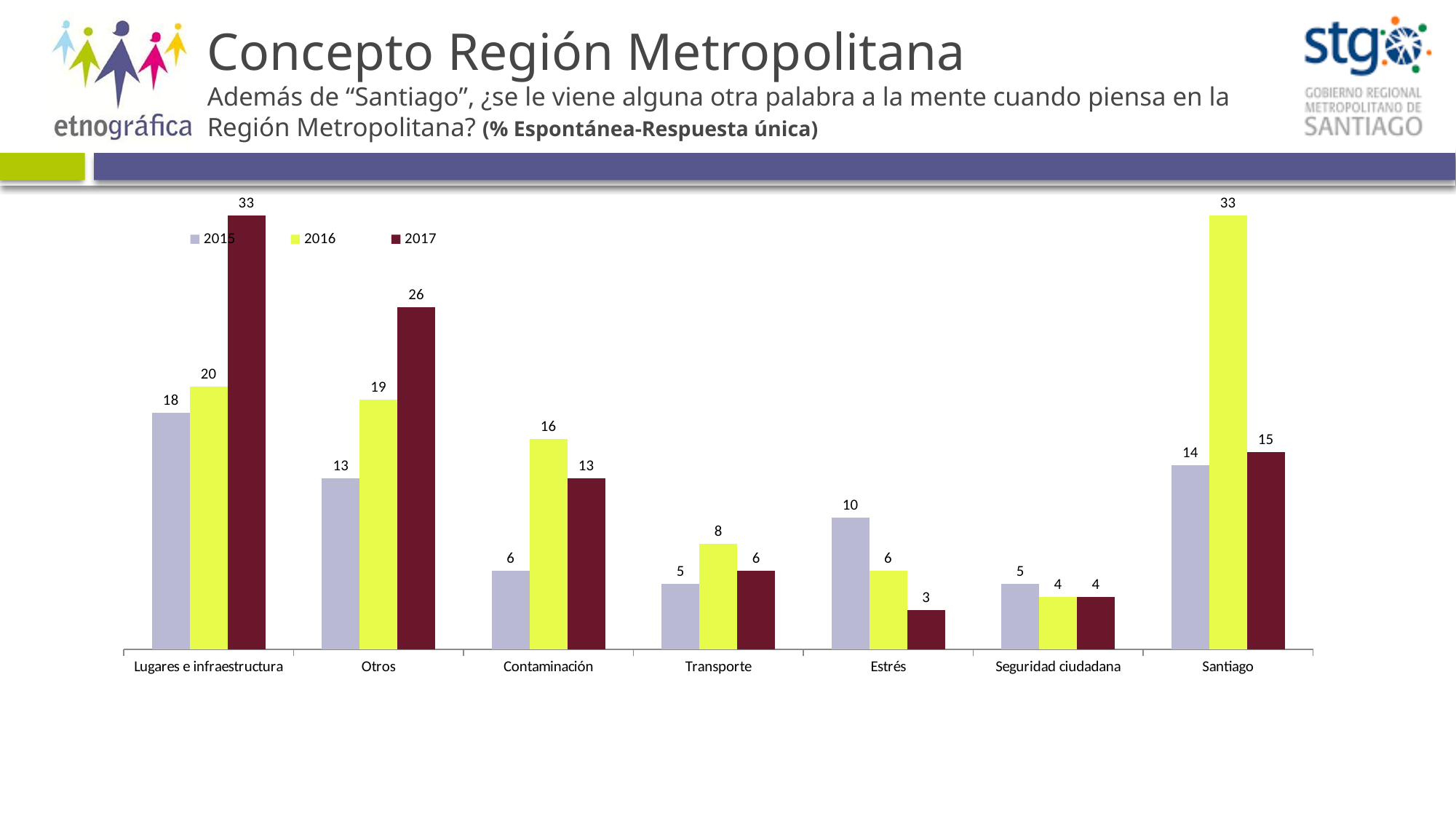
What is the 2015 value for Estrés? 10 Which category has the lowest 2017 value? Estrés What is the 2016 value for Contaminación? 16 Which is larger for Santiago, the 2016 value or the 2017 value? 2016 How many categories are shown on the x axis? 7 Which category has the highest 2016 value? Santiago What is the difference between the 2017 and 2015 values for Otros? 13 Do the 2017 values for Lugares e infraestructura, Otros and Contaminación rise or fall from left to right? Fall How many series does the legend list? 3 Which series is shown in dark red in the legend? 2017 What kind of chart is shown on the slide? Bar chart What is the 2017 value for Lugares e infraestructura? 33